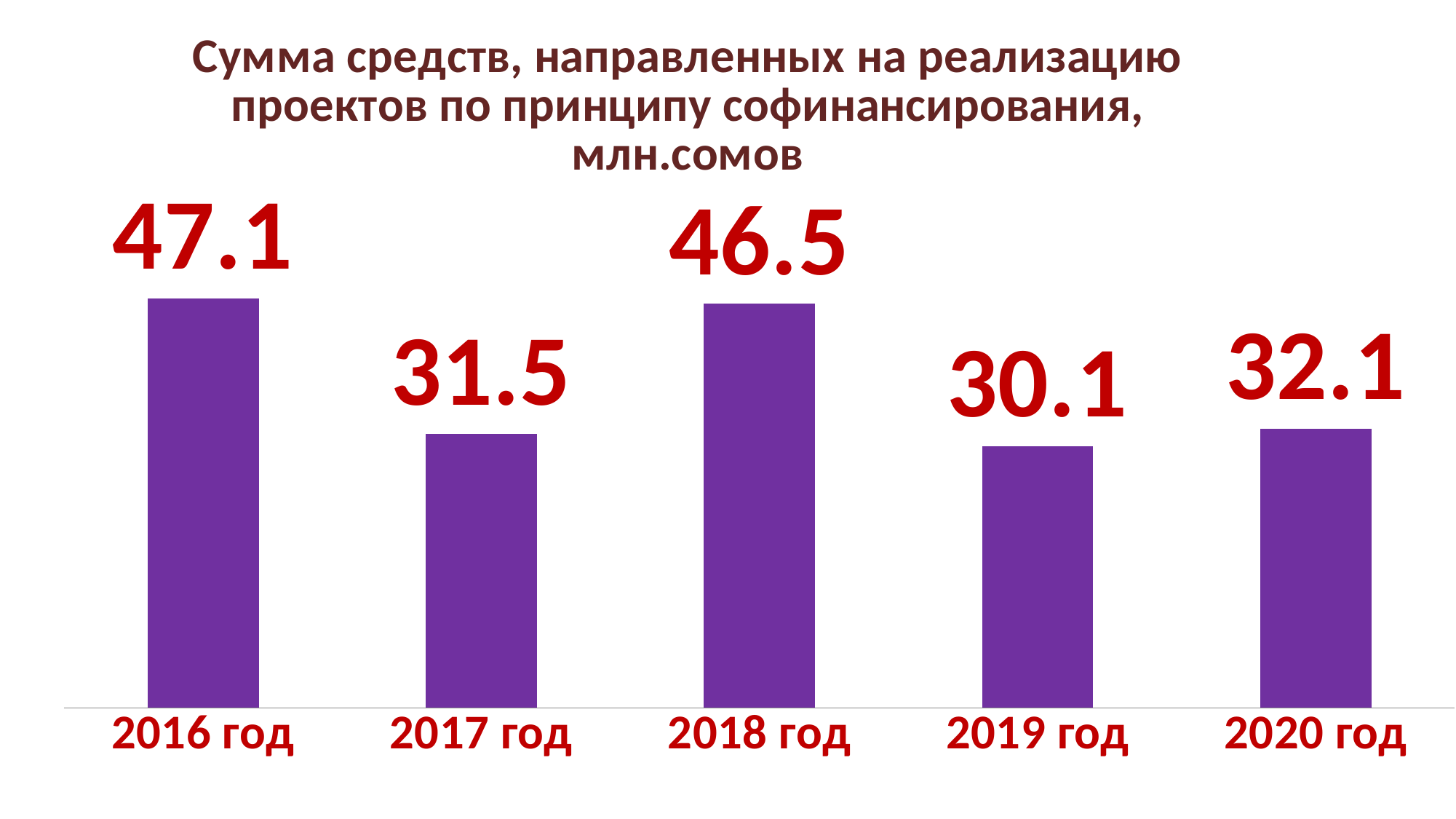
What unit is given in the chart title? млн.сомов Does the value rise or fall from 2018 год to 2019 год? fall Which year has the lowest value? 2019 год What kind of chart is this? bar chart Which year has the highest value? 2016 год How many years are shown on the chart? 5 What is the value for 2020 год? 32.1 What is the value for 2019 год? 30.1 Which is larger, the value for 2017 год or the value for 2020 год? 2020 год What is the value for 2016 год? 47.1 What is the difference between the values for 2018 год and 2019 год? 16.4 What is the difference between the values for 2016 год and 2017 год? 15.6